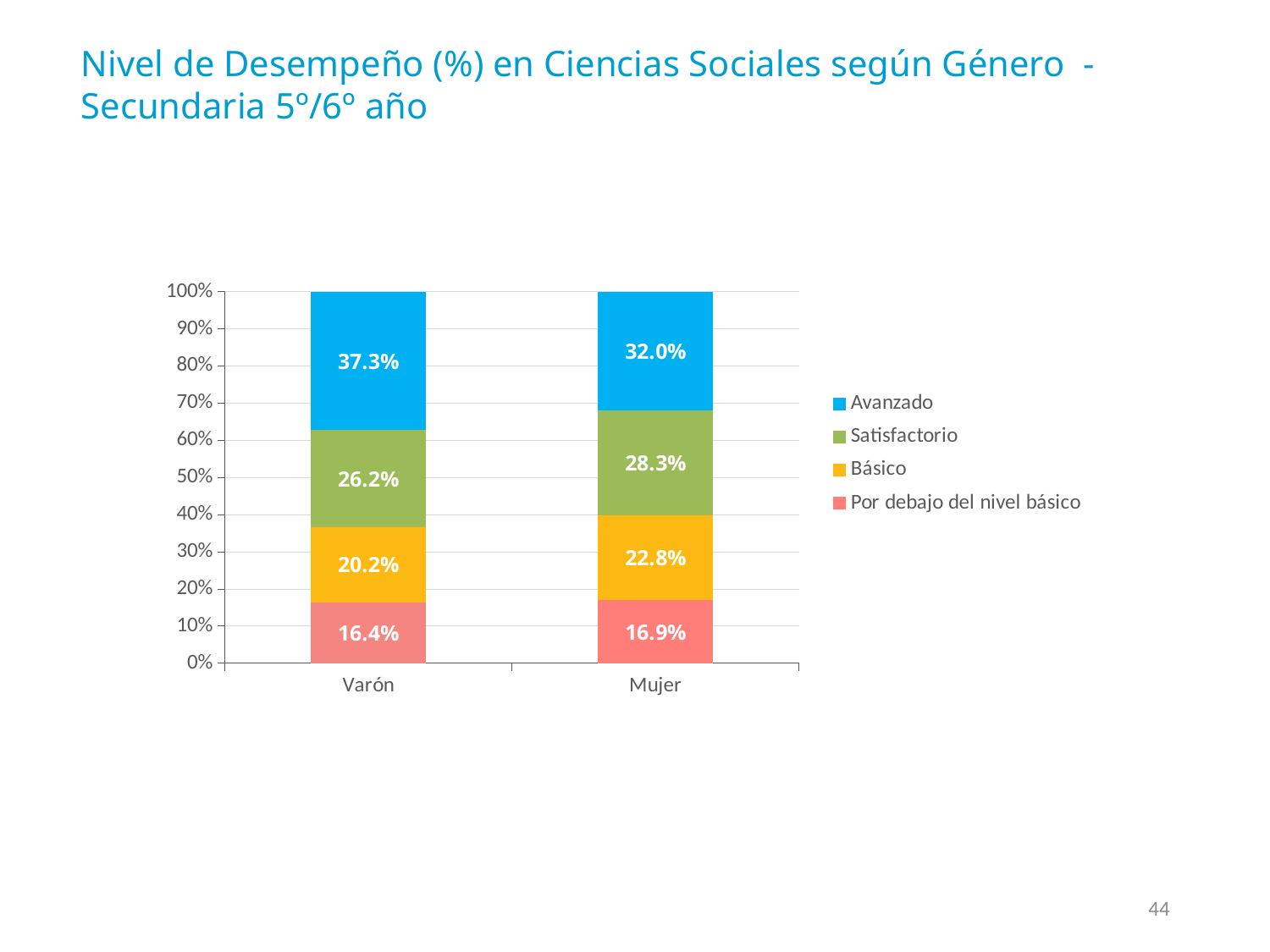
What is the Básico value for Varón? 20.2% What kind of chart is shown on the slide? Stacked bar chart How many series does the legend list? 4 What is the difference between the Avanzado values for Varón and Mujer? 5.3% Which performance level is the lowest for Varón? Por debajo del nivel básico How many categories are shown on the x axis? 2 What is the Satisfactorio value for Mujer? 28.3% What is the Por debajo del nivel básico value for Mujer? 16.9% Which gender has the higher Básico value? Mujer What is the difference between the Satisfactorio values for Mujer and Varón? 2.1% What is the Avanzado value for Varón? 37.3% Which gender has the higher Avanzado value? Varón